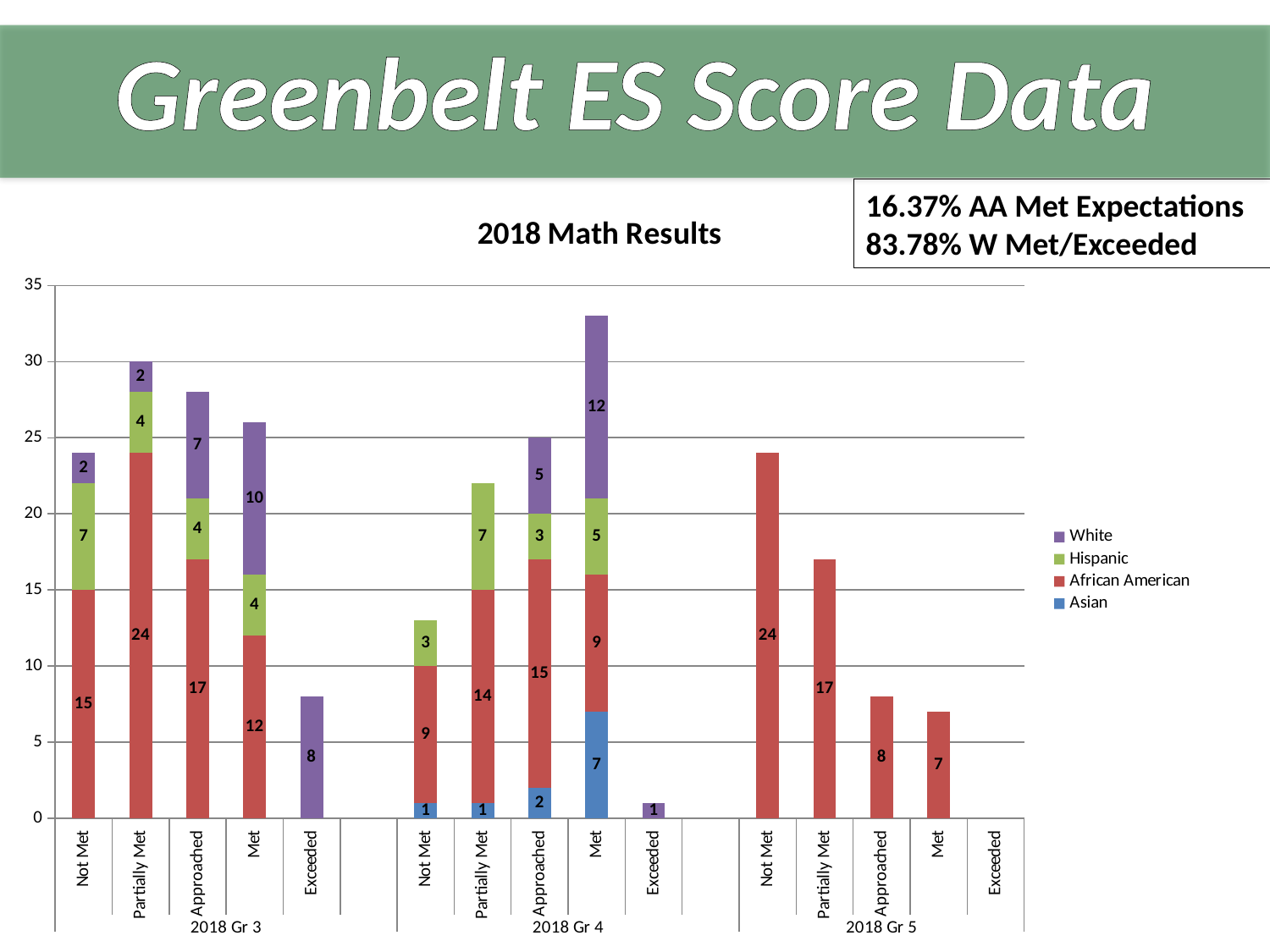
Which is larger: the Hispanic value for Partially Met in 2018 Gr 4 or the Hispanic value for Not Met in 2018 Gr 4? Partially Met Which category in 2018 Gr 5 has the lowest African American value? Met What is the White value for Met in 2018 Gr 4? 12 What is the title of the chart? 2018 Math Results What is the total of the stacked bar for Not Met in 2018 Gr 3? 24 What is the African American value for Not Met in 2018 Gr 5? 24 What type of chart is shown on the slide? Stacked bar chart What is the total of the stacked bar for Met in 2018 Gr 4? 33 How many series does the legend list? 4 What is the difference between the African American values for Approached and Met in 2018 Gr 3? 5 What is the African American value for Partially Met in 2018 Gr 3? 24 What is the Asian value for Met in 2018 Gr 4? 7